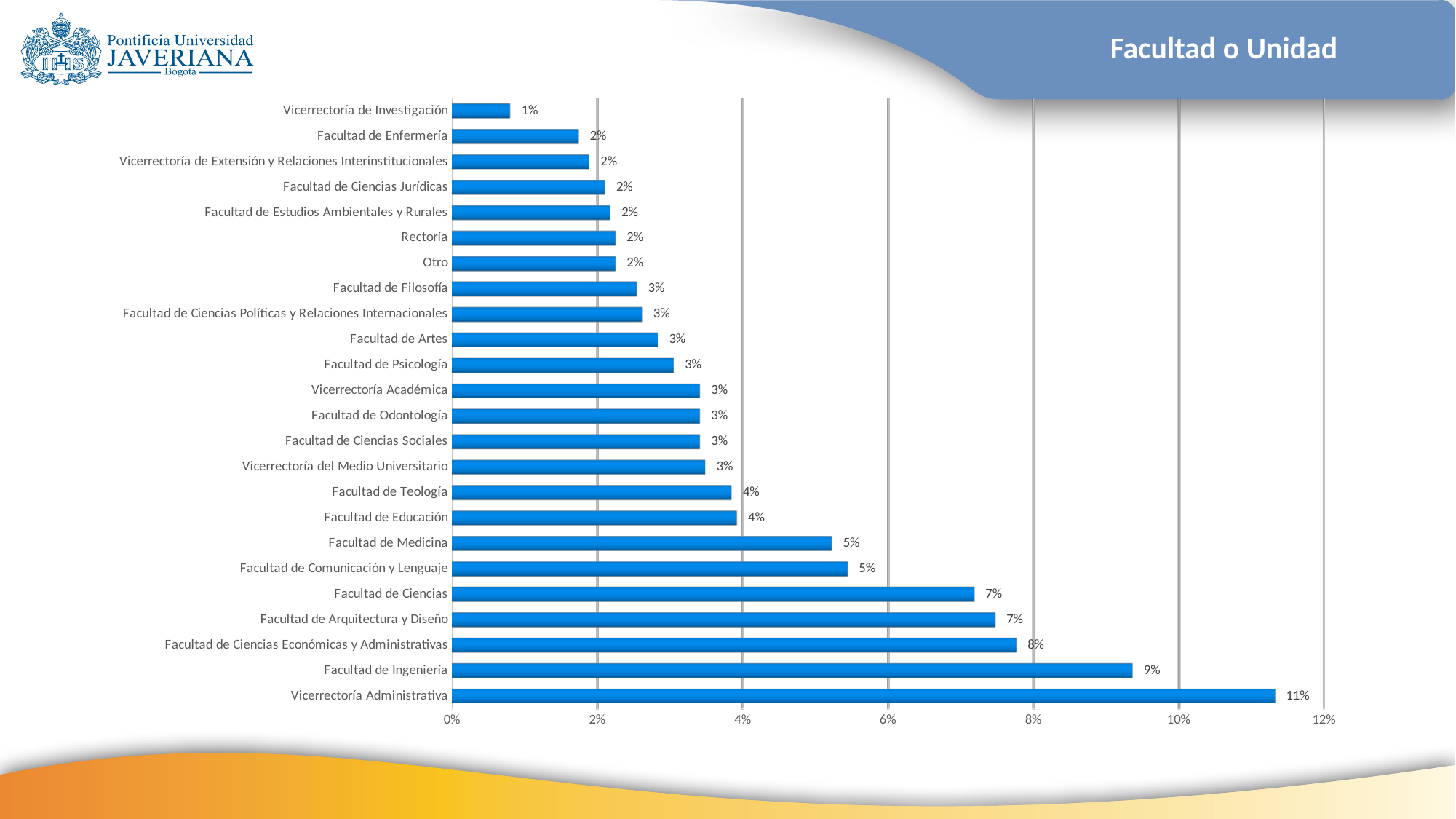
Which category has the lowest value? Vicerrectoría de Investigación What is the value for Facultad de Enfermería? 2% What kind of chart is shown on the slide? Bar chart What is the value for Facultad de Ciencias Económicas y Administrativas? 8% How many categories are shown in the chart? 24 What is the value for Facultad de Medicina? 5% Which is larger, the value for Facultad de Ciencias or the value for Facultad de Comunicación y Lenguaje? Facultad de Ciencias What is the title shown in the slide header? Facultad o Unidad Which category has the highest value? Vicerrectoría Administrativa Is the value for Facultad de Ingeniería greater or less than 10%? less What is the value for Facultad de Ingeniería? 9% Is the value for Facultad de Medicina greater or less than 4%? greater